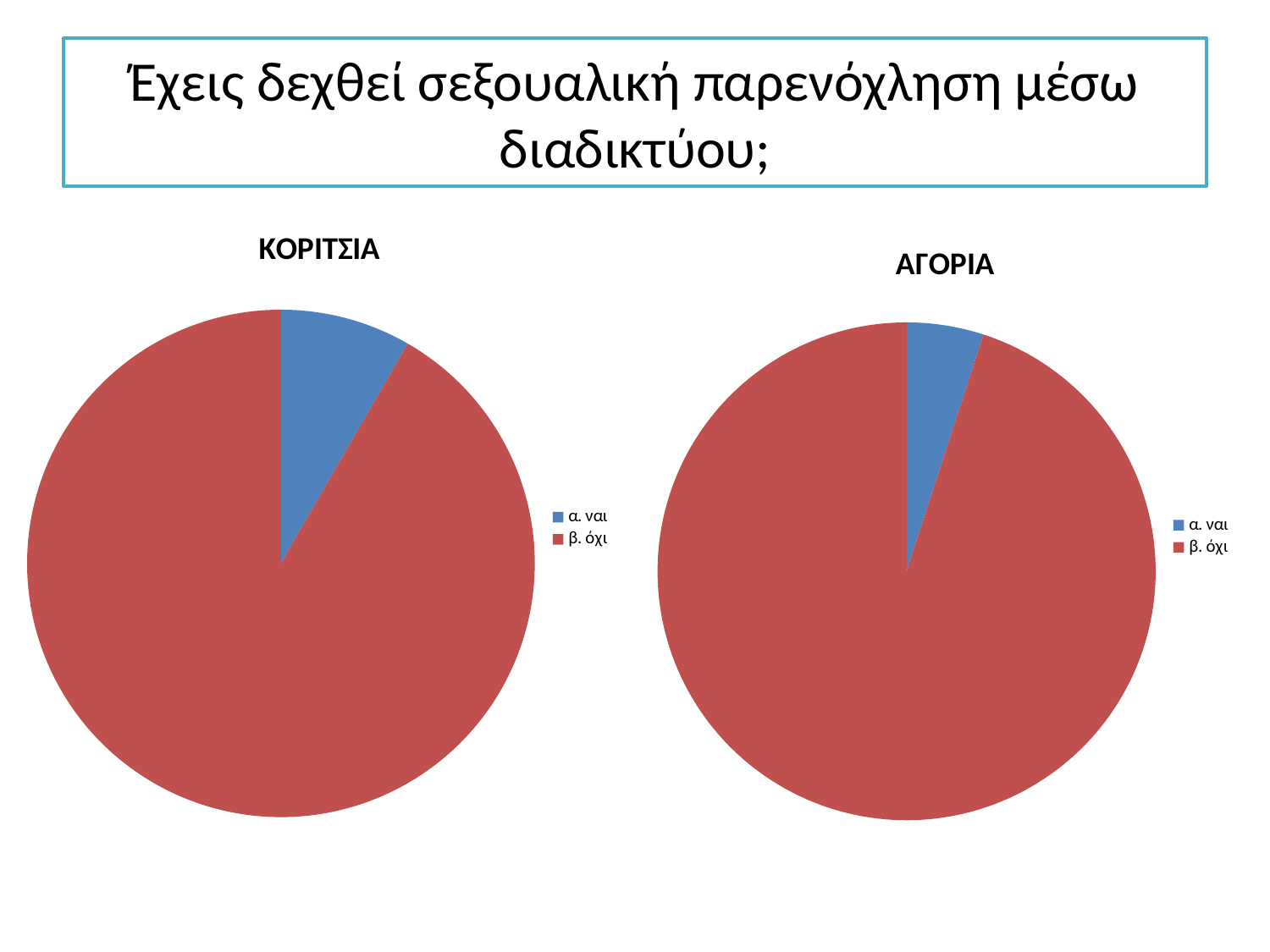
What is the title of the chart on the right of the slide? ΑΓΟΡΙΑ In the ΑΓΟΡΙΑ chart, which category has the largest slice? β. όχι In the ΑΓΟΡΙΑ chart, which category has the smallest slice? α. ναι What colour represents β. όχι in the ΑΓΟΡΙΑ chart? red In the ΚΟΡΙΤΣΙΑ chart, which category has the smallest slice? α. ναι In the ΚΟΡΙΤΣΙΑ chart, which category has the largest slice? β. όχι What kind of chart is the ΑΓΟΡΙΑ chart? pie chart In the ΚΟΡΙΤΣΙΑ chart, which is larger, the α. ναι slice or the β. όχι slice? β. όχι What kind of chart is the ΚΟΡΙΤΣΙΑ chart? pie chart How many slices does the ΚΟΡΙΤΣΙΑ pie chart have? 2 Which chart has the larger α. ναι slice, ΚΟΡΙΤΣΙΑ or ΑΓΟΡΙΑ? ΚΟΡΙΤΣΙΑ How many entries does the legend of the ΑΓΟΡΙΑ chart list? 2